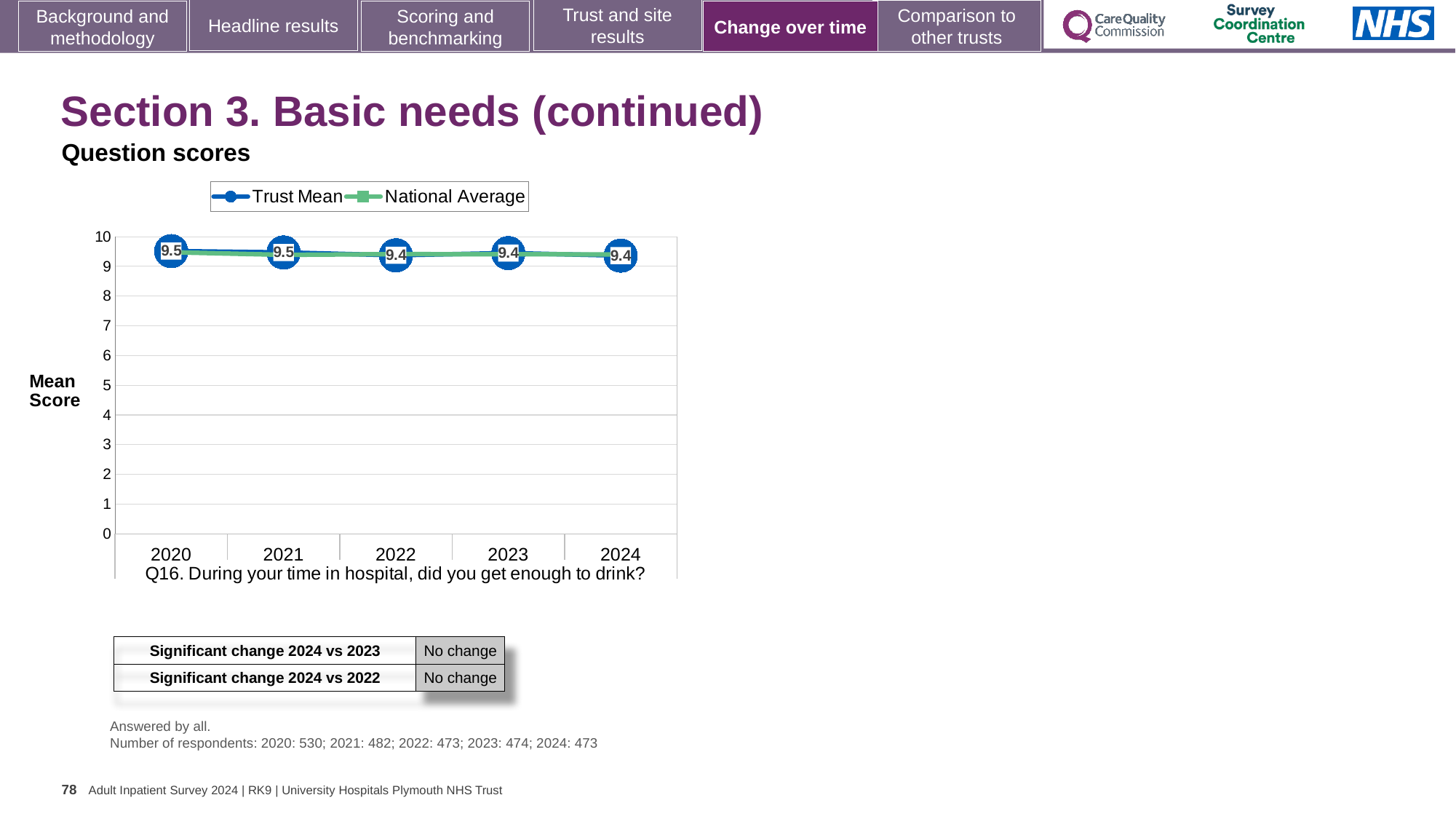
What is the Trust Mean score for 2020? 9.5 What is the Trust Mean score for 2024? 9.4 How many years are plotted on the x axis? 5 Does the Trust Mean rise or fall from 2020 to 2024? Fall Which year has the larger Trust Mean, 2020 or 2024? 2020 What is the difference between the Trust Mean in 2020 and in 2024? 0.1 What kind of chart is shown? Line chart How many series does the legend list? 2 Which survey question does the chart show scores for? Q16. During your time in hospital, did you get enough to drink? What is the Trust Mean score for 2021? 9.5 What is the Trust Mean score for 2022? 9.4 Is the National Average value for 2024 greater or less than 9? greater